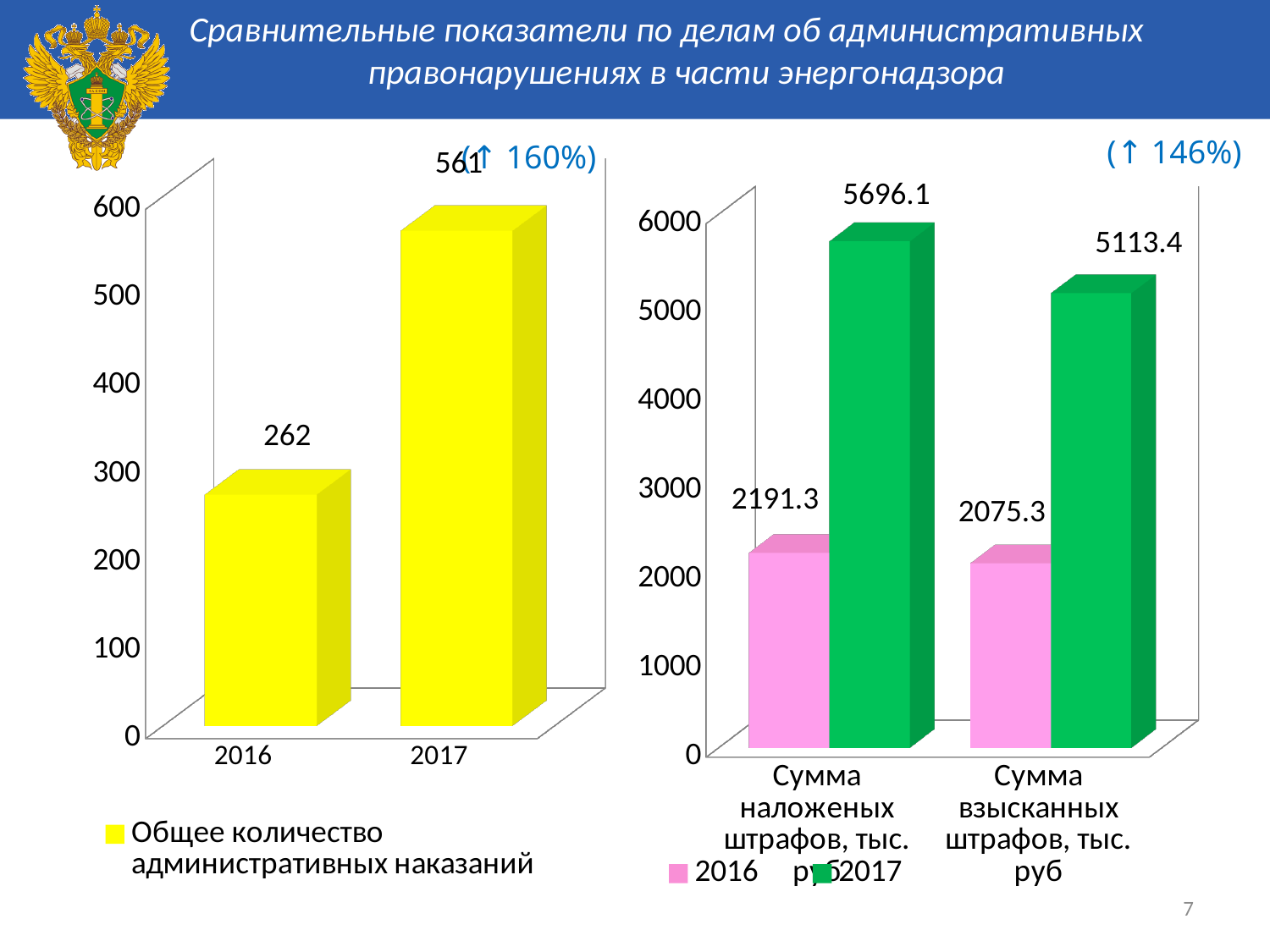
In the left chart, what is the value for 2016? 262 In the right chart, which is larger: the 2016 value for Сумма наложеных штрафов or the 2016 value for Сумма взысканных штрафов? Сумма наложеных штрафов In the left chart, do the values rise or fall from 2016 to 2017? rise In the right chart, what is the 2017 value for Сумма наложеных штрафов, тыс. руб? 5696.1 In the right chart, which bar is the highest? 2017, Сумма наложеных штрафов, тыс. руб In the right chart, what is the difference between the 2017 and 2016 values for Сумма взысканных штрафов, тыс. руб? 3038.1 In the left chart, what is the value for 2017? 561 In the right chart, what is the 2016 value for Сумма взысканных штрафов, тыс. руб? 2075.3 In the left chart, what kind of chart is shown? bar chart In the right chart, how many series does the legend list? 2 In the right chart, what is the 2016 value for Сумма наложеных штрафов, тыс. руб? 2191.3 In the left chart, what is the difference between the 2017 and 2016 values? 299